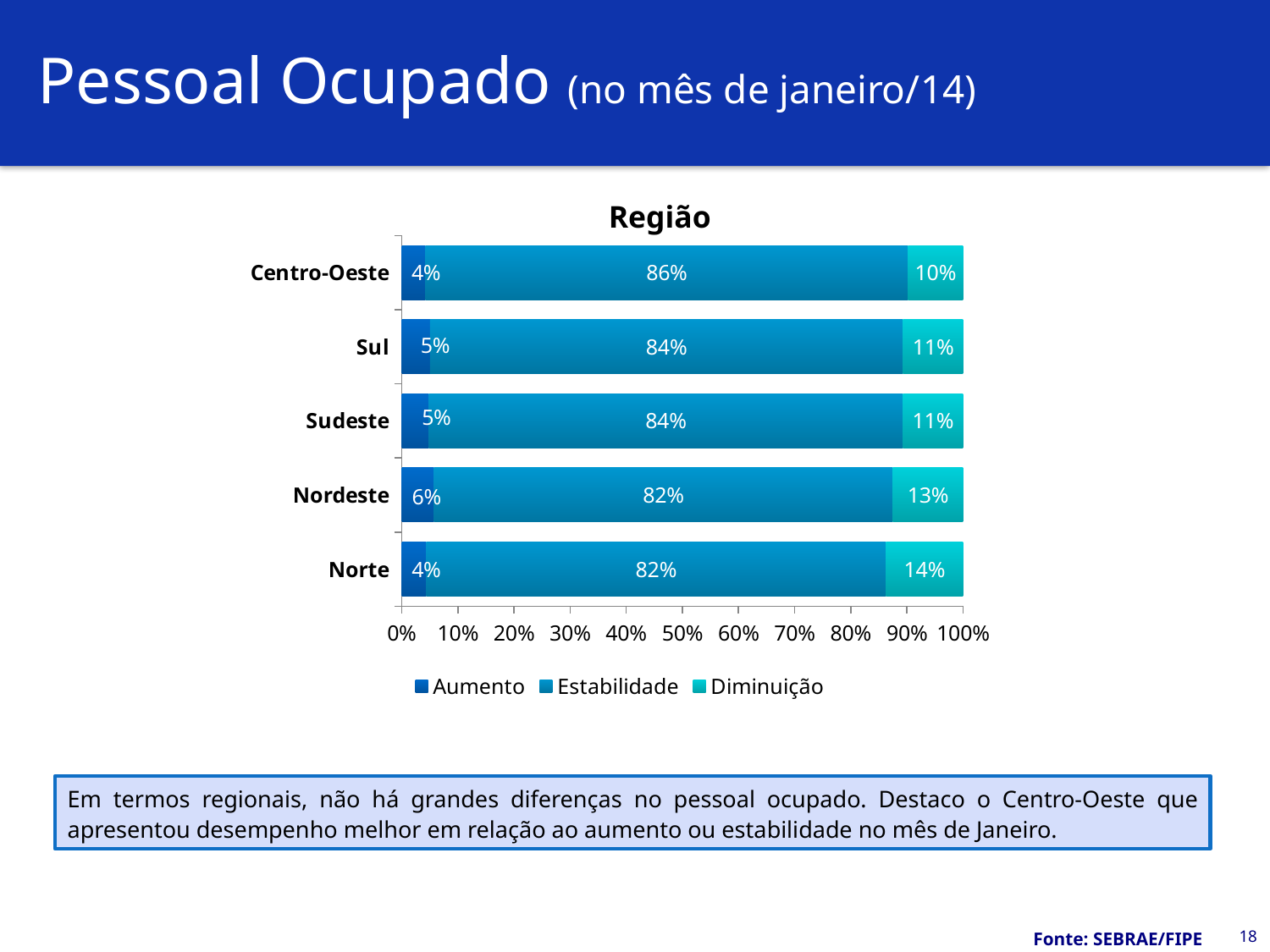
What is the title of the chart? Região Which region has the lowest Diminuição value? Centro-Oeste Which is larger, the Aumento value for Nordeste or the Aumento value for Norte? Nordeste What is the Diminuição value for Norte? 14% What is the Aumento value for Nordeste? 6% Which region has the highest Estabilidade value? Centro-Oeste Which series is shown in the lightest (cyan) colour in the legend? Diminuição What is the Estabilidade value for Centro-Oeste? 86% How many regions are shown in the chart? 5 What is the difference between the Diminuição values for Norte and Centro-Oeste? 4% What type of chart is shown on the slide? Stacked bar chart How many series does the legend list? 3